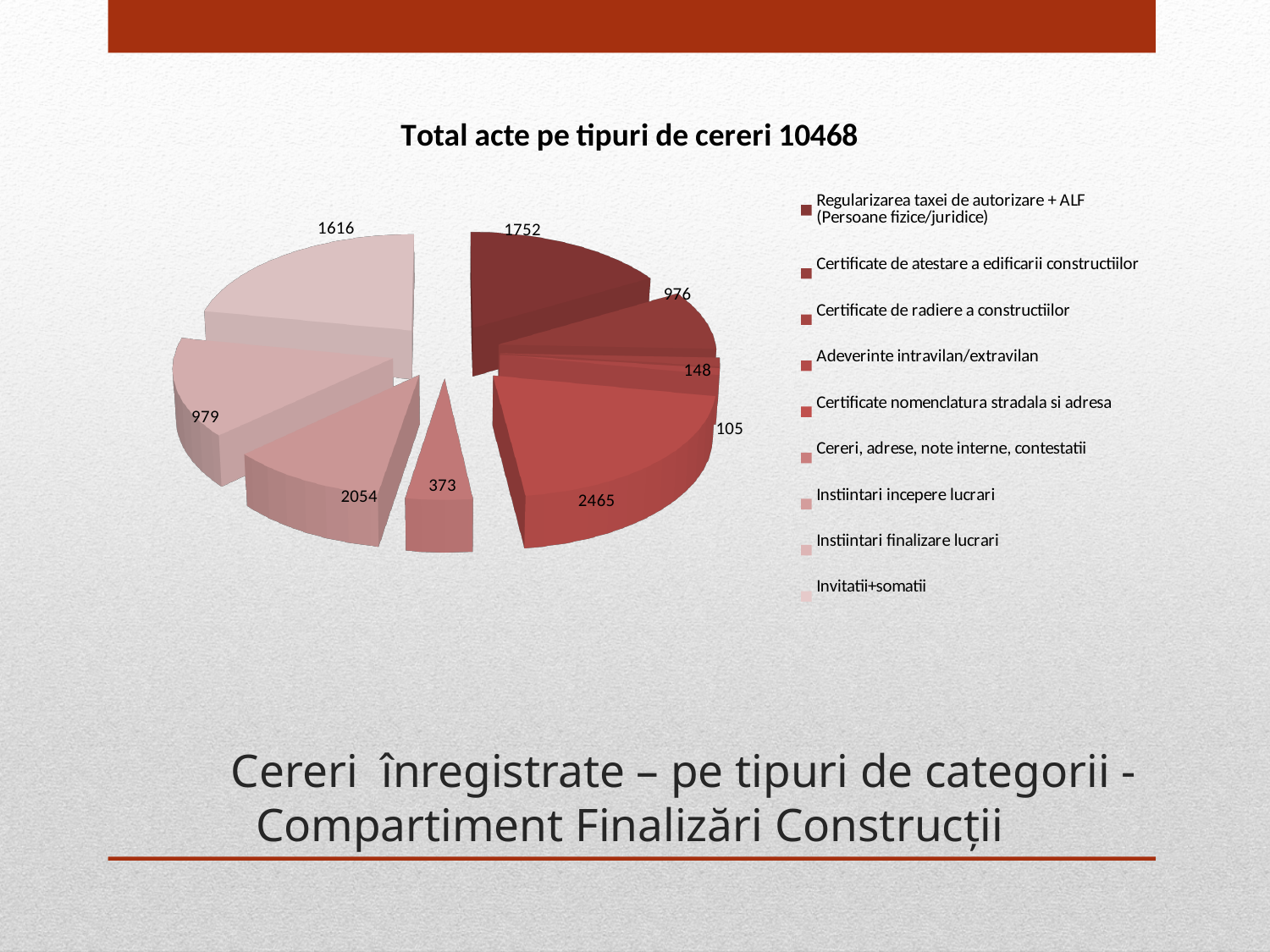
What is the difference between the largest slice (2465) and the slice labelled 2054? 411 What is the title of the chart? Total acte pe tipuri de cereri 10468 What is the value for Instiintari incepere lucrari? 2054 What is the value of the smallest slice in the pie chart? 105 How many entries does the chart legend list? 9 Which category has the largest slice in the pie chart? Certificate nomenclatura stradala si adresa Which is larger, the slice labelled 976 or the slice labelled 979? 979 How many slices does the pie chart have? 9 What is the value for Regularizarea taxei de autorizare + ALF (Persoane fizice/juridice)? 1752 What is the value of the largest slice in the pie chart? 2465 What is the value for Invitatii+somatii? 1616 What kind of chart is shown on the slide? Pie chart